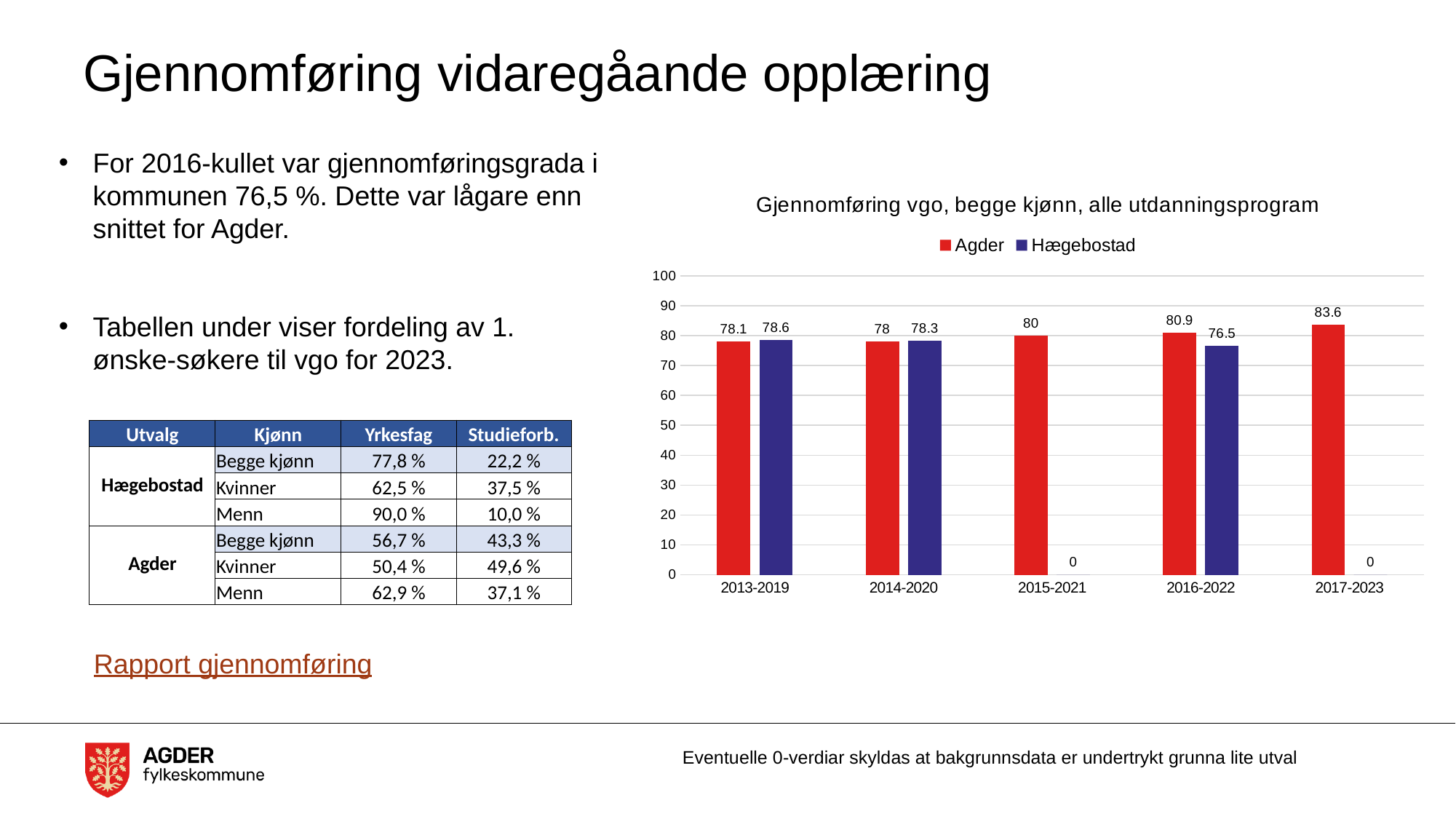
In which period is the Agder value highest? 2017-2023 What is the title of the chart? Gjennomføring vgo, begge kjønn, alle utdanningsprogram How many series does the legend list? 2 What is the value for Agder in 2014-2020? 78 What is the value for Agder in 2017-2023? 83.6 What kind of chart is shown? Bar chart How many periods are shown on the x axis? 5 Which is larger in 2013-2019, the Agder value or the Hægebostad value? Hægebostad What is the value for Hægebostad in 2016-2022? 76.5 What is the value for Hægebostad in 2013-2019? 78.6 In which period is the Agder value lowest? 2014-2020 What is the difference between the Agder and Hægebostad values in 2016-2022? 4.4